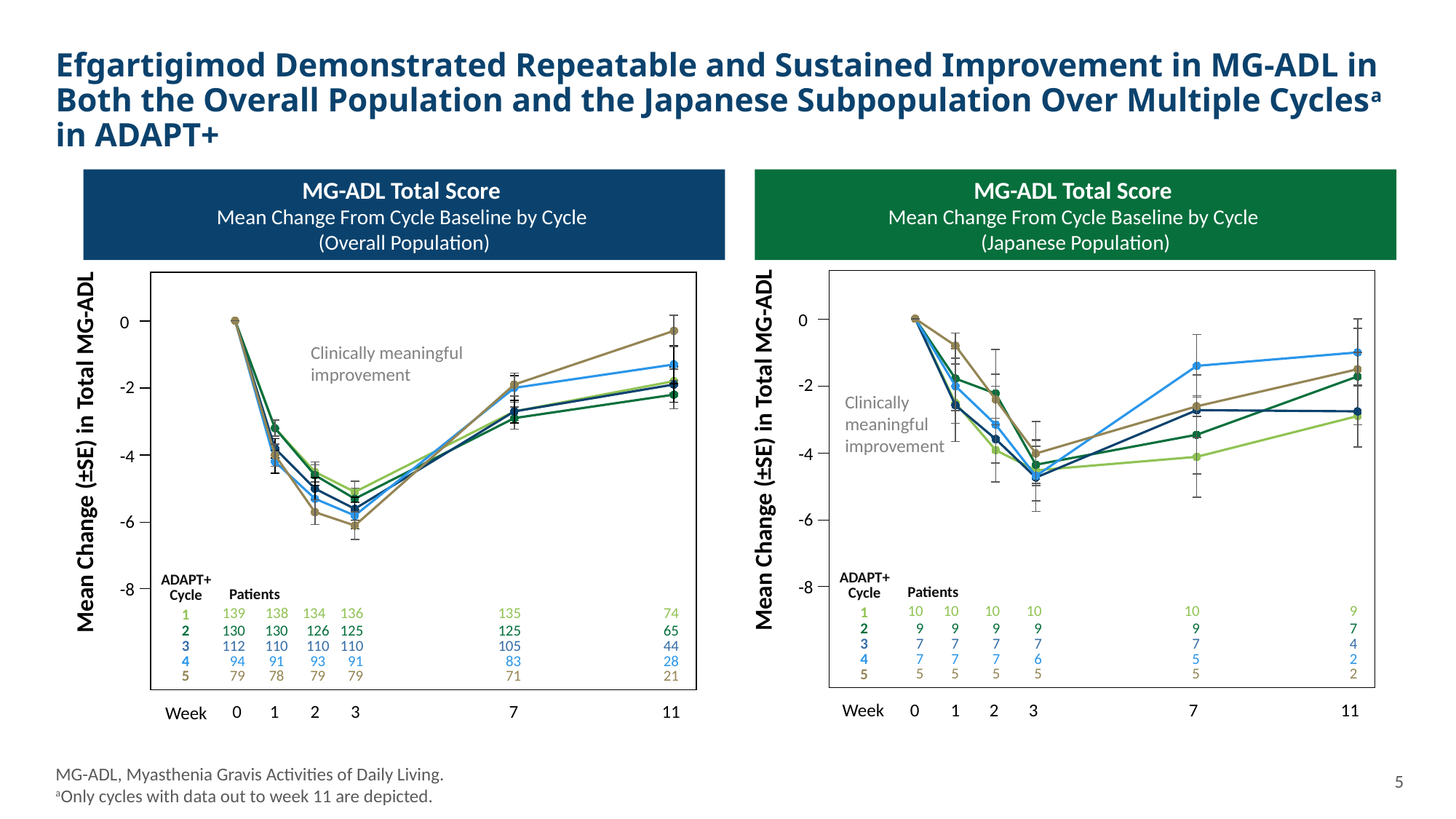
In the Japanese Population chart, how many week time points are shown on the x axis? 6 In the Overall Population chart, how many patients were in cycle 5 at week 11? 21 What kind of chart is the MG-ADL Total Score (Overall Population) chart? line chart In the Overall Population chart, is the mean change for cycle 5 at week 11 greater or less than -2? greater In the Japanese Population chart, is the mean change for cycle 1 at week 7 greater or less than -2? less In the Japanese Population chart, how many patients were in cycle 3 at week 11? 4 In the Overall Population chart, what is the difference between the number of cycle 1 patients at week 0 and at week 11? 65 In the Overall Population chart, how many patients were in cycle 1 at week 0? 139 In the Overall Population chart, which cycle has the highest mean change (closest to 0) at week 11? Cycle 5 In the Overall Population chart, do the mean change values rise or fall from week 3 to week 11? rise In the Japanese Population chart, which cycle has the lowest mean change at week 7? Cycle 1 In the Overall Population chart, how many ADAPT+ cycles are plotted? 5